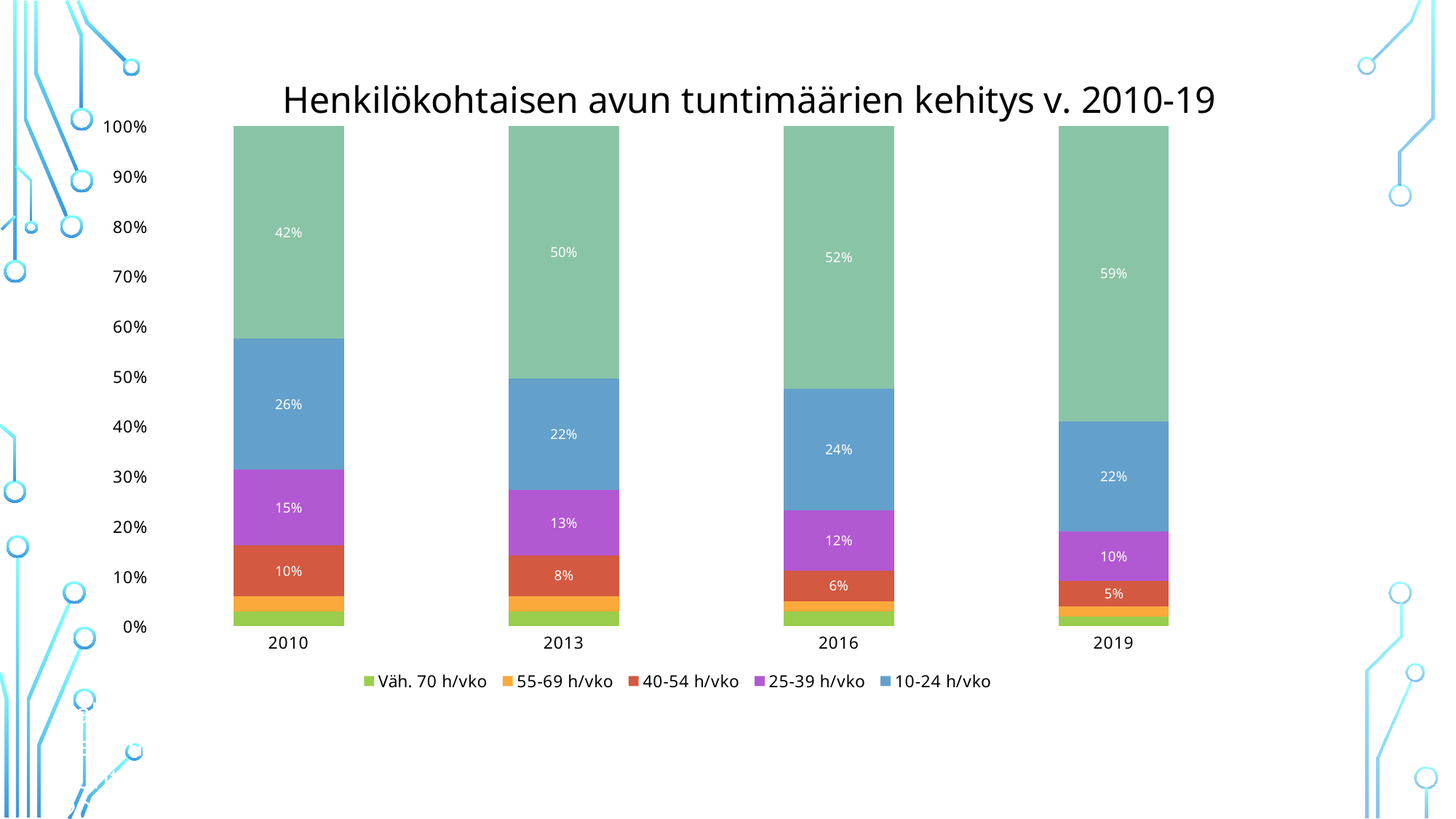
What is the value for 25-39 h/vko in 2019? 10% Which year has the larger 10-24 h/vko share, 2013 or 2016? 2016 What is the value for 25-39 h/vko in 2013? 13% In which year is the 40-54 h/vko share lowest? 2019 How many years are shown on the x axis? 4 How many series does the legend list? 5 What is the difference between the 25-39 h/vko share in 2010 and in 2019? 5 percentage points What is the value for 40-54 h/vko in 2016? 6% In which year is the 10-24 h/vko share highest? 2010 What kind of chart is shown on the slide? Stacked bar chart What is the value for 10-24 h/vko in 2010? 26% Does the 40-54 h/vko share rise or fall from 2010 to 2019? Fall